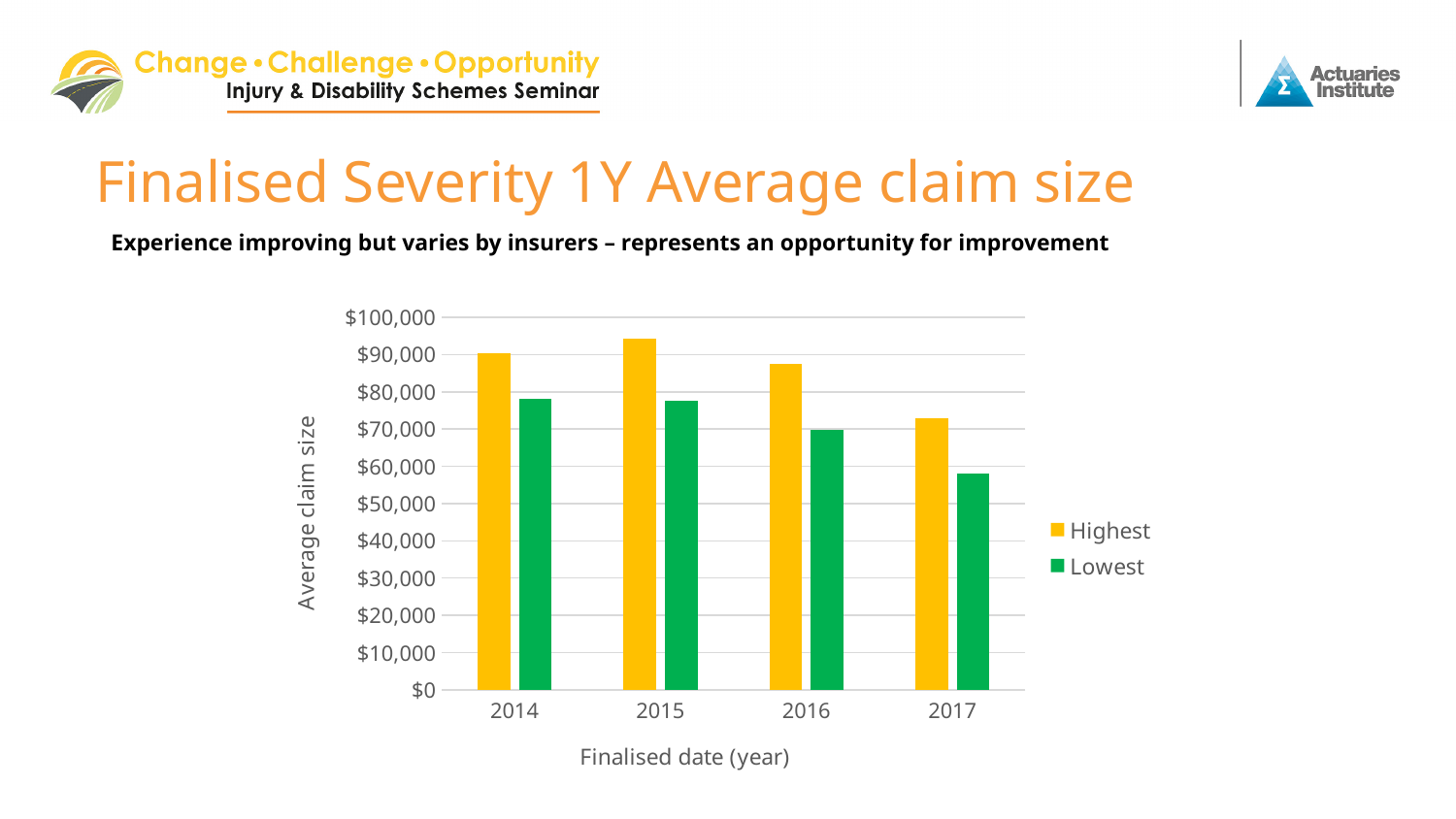
How many series does the legend list? 2 In which year is the Lowest average claim size the smallest? 2017 Does the Lowest series rise or fall from 2014 to 2017? Fall In which year is the Highest average claim size the largest? 2015 Is the Highest value for 2015 greater or less than $90,000? greater What kind of chart is shown on the slide? Bar chart In which year is the Highest average claim size the smallest? 2017 How many years are shown on the x axis? 4 Is the Lowest value for 2014 greater or less than $80,000? less What is the title of the vertical axis? Average claim size Is the Highest value for 2016 greater or less than $90,000? less